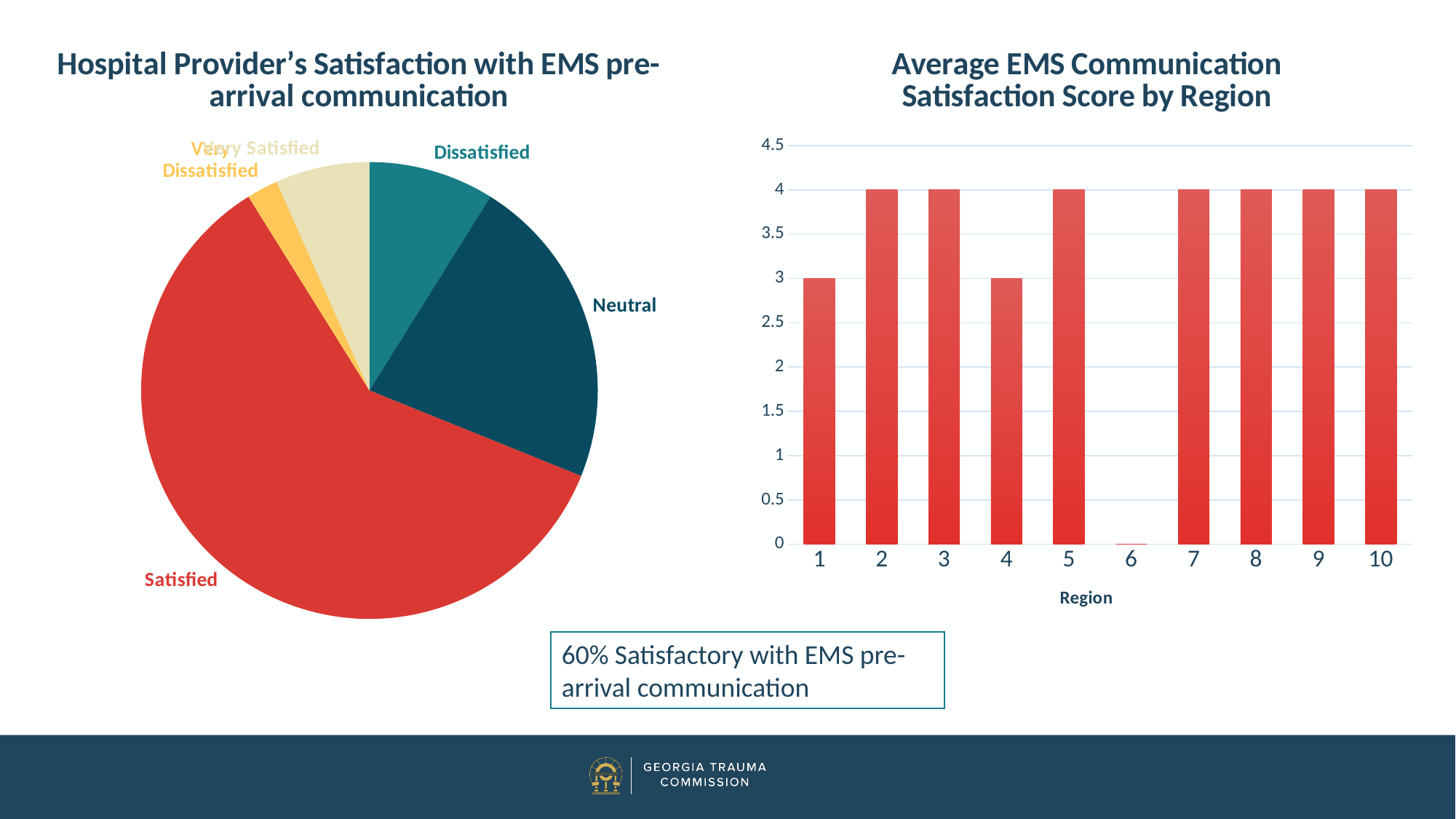
In the right bar chart, is the value for Region 4 greater or less than 3.5? less In the left pie chart, which category has the smallest slice? Very Dissatisfied In the right bar chart, what is the difference between the scores for Region 2 and Region 4? 1 In the right bar chart, what is the average satisfaction score for Region 5? 4 In the left pie chart, which category has the largest slice? Satisfied What kind of chart is the right chart, 'Average EMS Communication Satisfaction Score by Region'? bar chart How many categories are shown in the left pie chart? 5 In the left pie chart, which slice is larger: Neutral or Dissatisfied? Neutral In the right bar chart, what is the average satisfaction score for Region 1? 3 In the right bar chart, how many regions are shown on the x axis? 10 In the right bar chart, which region has the lowest average satisfaction score? 6 What kind of chart is the left chart, 'Hospital Provider's Satisfaction with EMS pre-arrival communication'? pie chart